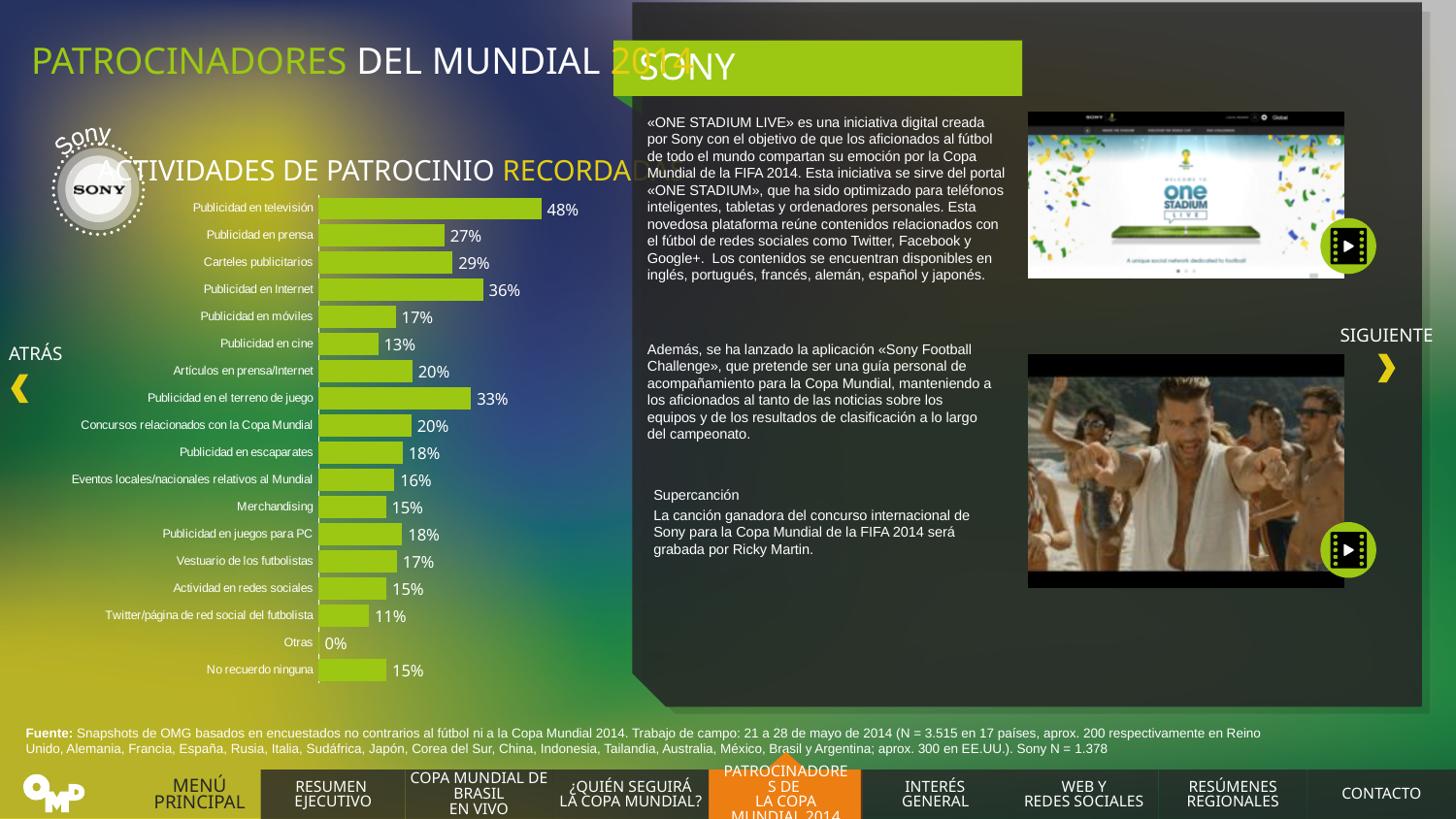
What is the difference between Publicidad en el terreno de juego and Concursos relacionados con la Copa Mundial? 13% What kind of chart is shown on the slide? Bar chart Which category has the lowest value? Otras Which is larger, Carteles publicitarios or Publicidad en prensa? Carteles publicitarios What is the value for Publicidad en el terreno de juego? 33% How many categories are shown in the bar chart? 18 What is the value for Publicidad en televisión? 48% What is the value for No recuerdo ninguna? 15% Which is larger, Publicidad en cine or Publicidad en móviles? Publicidad en móviles Which category has the highest value? Publicidad en televisión What is the difference between Publicidad en televisión and Publicidad en Internet? 12% What is the value for Twitter/página de red social del futbolista? 11%